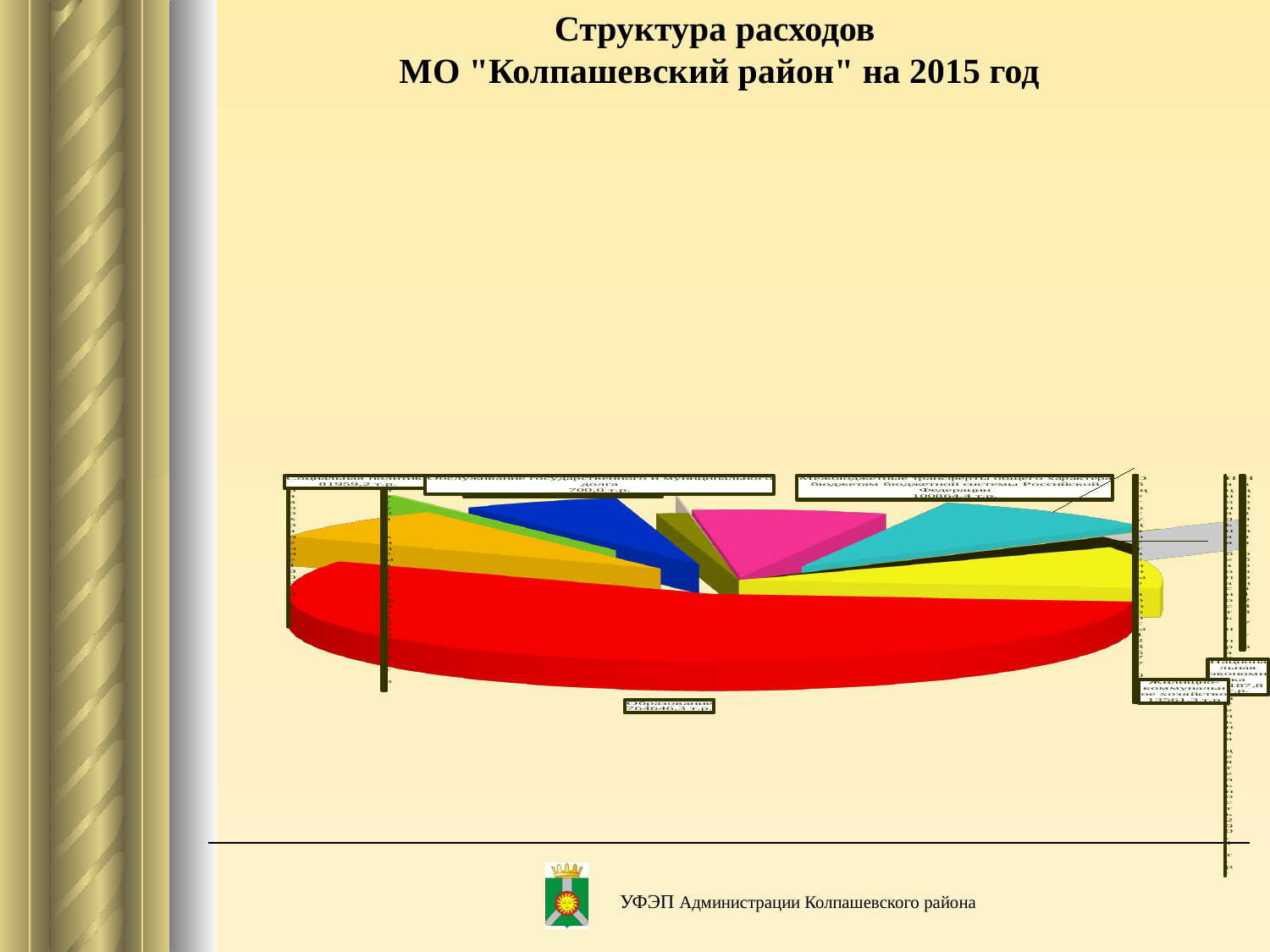
What is the value shown for Социальная политика? 81959,2 т.р. What is the value shown for Образование? 764646,3 т.р. Which category has the largest slice of the pie? Образование What is the difference between the values for Образование and Социальная политика? 682687,1 т.р. What kind of chart is shown on the slide? pie chart What colour is the slice for Образование? red Which is larger: Социальная политика or Обслуживание государственного и муниципального долга? Социальная политика What is the difference between the values for Социальная политика and Обслуживание государственного и муниципального долга? 81259,2 т.р. What is the title of the chart on the slide? Структура расходов МО "Колпашевский район" на 2015 год What is the value shown for Обслуживание государственного и муниципального долга? 700,0 т.р.